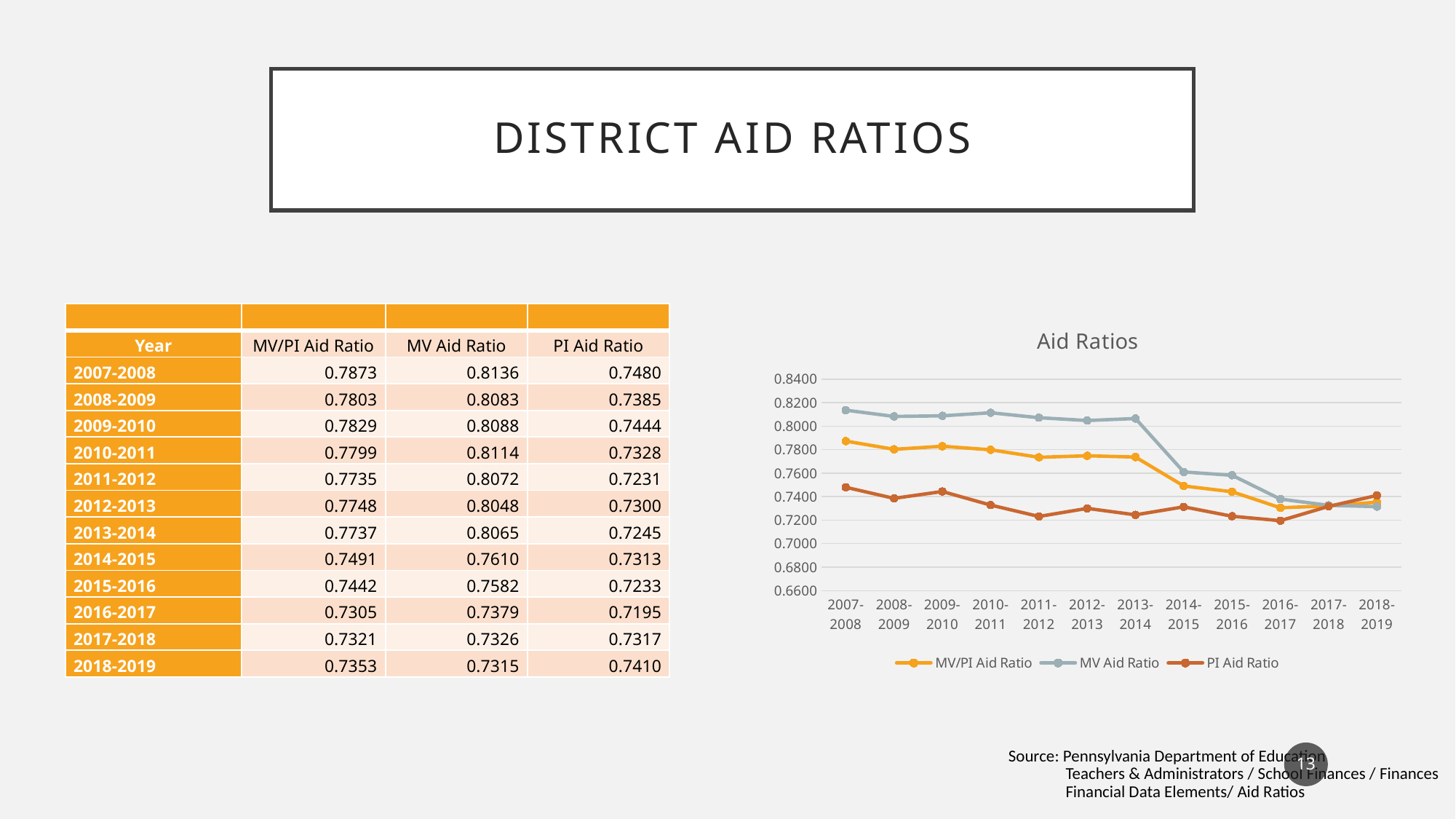
In which year is the PI Aid Ratio lowest? 2016-2017 Is the MV Aid Ratio for 2007-2008 greater or less than 0.8000? greater How many series does the legend of the "Aid Ratios" chart list? 3 What kind of chart is the "Aid Ratios" chart? line chart By how much did the MV Aid Ratio fall from 2013-2014 to 2014-2015? 0.0455 What is the MV/PI Aid Ratio for 2014-2015? 0.7491 In 2018-2019, which is larger: the PI Aid Ratio or the MV Aid Ratio? PI Aid Ratio What is the MV Aid Ratio for 2007-2008? 0.8136 How many years are plotted along the x axis of the "Aid Ratios" chart? 12 In which year is the MV Aid Ratio highest? 2007-2008 Does the MV Aid Ratio line generally rise or fall from 2007-2008 to 2018-2019? fall What is the PI Aid Ratio for 2018-2019? 0.7410